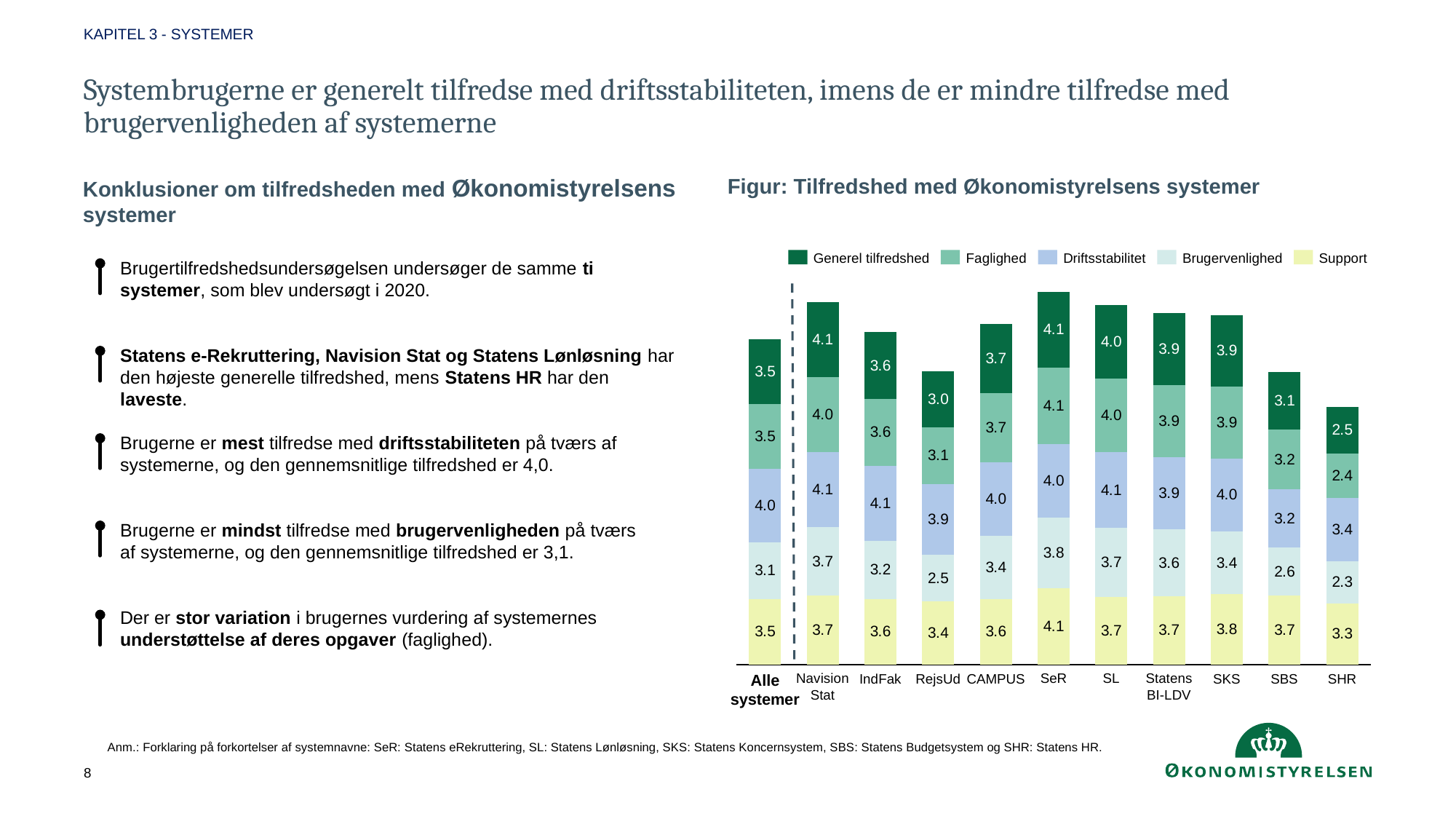
Which series is shown in dark green at the top of each stacked bar? Generel tilfredshed Which system has the lowest Generel tilfredshed value? SHR What is the difference between the Driftsstabilitet value and the Brugervenlighed value for 'Alle systemer'? 0.9 What is the Brugervenlighed value for RejsUd? 2.5 What is the total of the stacked bar for SHR? 13.9 What is the Driftsstabilitet value for 'Alle systemer'? 4.0 How many series does the legend of the chart list? 5 Which is larger: the Support value for SeR or the Support value for SHR? SeR How many systems (categories) are shown along the x axis of the chart, including 'Alle systemer'? 11 What kind of chart is shown in the figure 'Tilfredshed med Økonomistyrelsens systemer'? Stacked bar chart Which system has the lowest Brugervenlighed value? SHR What is the Support value for SeR? 4.1